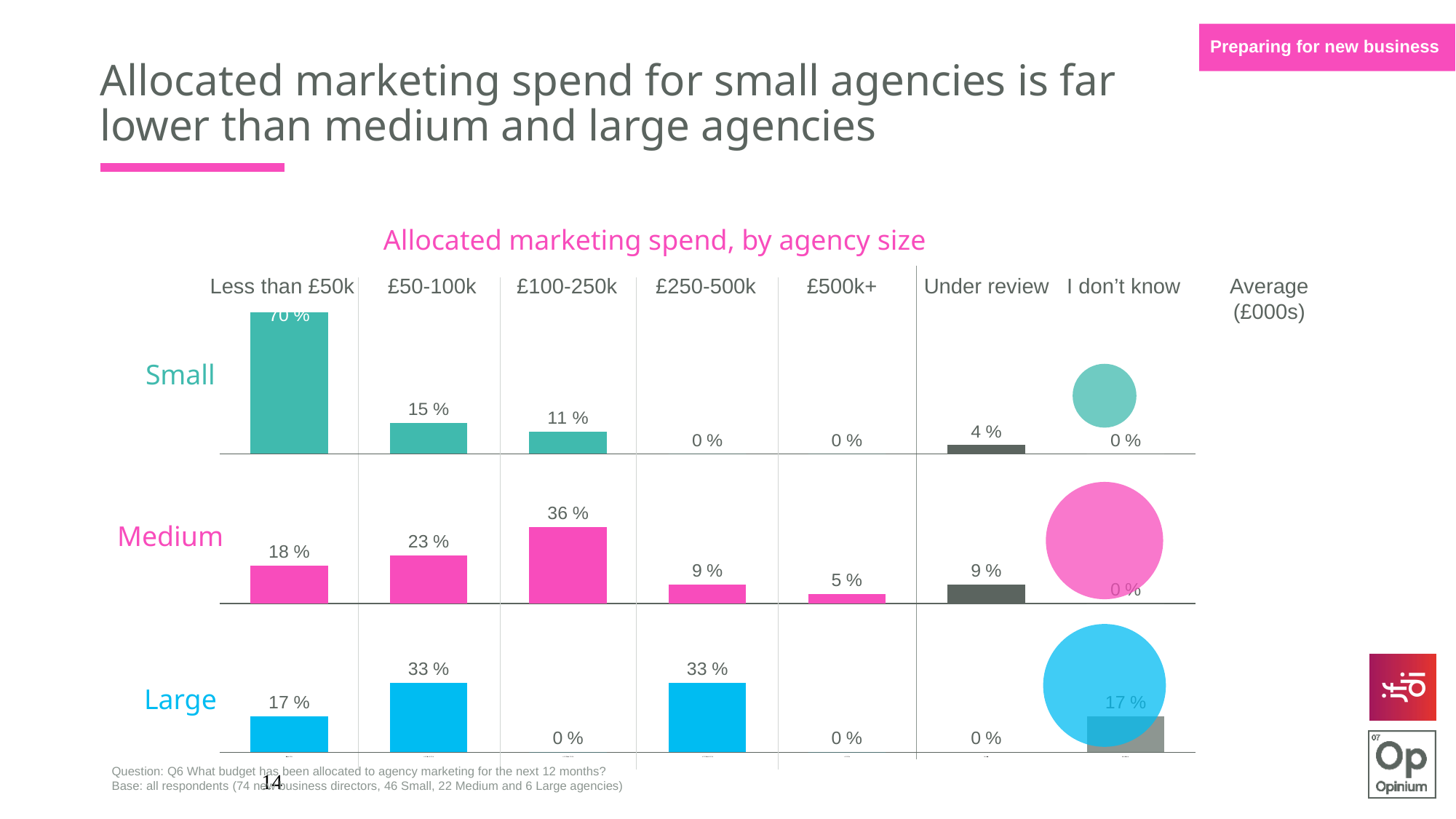
What percentage of Large agencies answered 'I don't know'? 17 % What percentage of Medium agencies have their marketing spend under review? 9 % What is the difference between the Medium and Small shares in the £50-100k band? 8 % In the £250-500k band, which is larger: the share for Medium agencies or for Large agencies? Large What percentage of Large agencies allocated £50-100k? 33 % Which spend band has the highest share among Medium agencies? £100-250k What percentage of Medium agencies allocated £500k+? 5 % What percentage of Medium agencies allocated £100-250k to marketing spend? 36 % What is the title of the chart? Allocated marketing spend, by agency size How many agency size groups are shown in the chart? 3 What percentage of Small agencies allocated £50-100k? 15 % Which agency size has the highest share in the £100-250k band? Medium